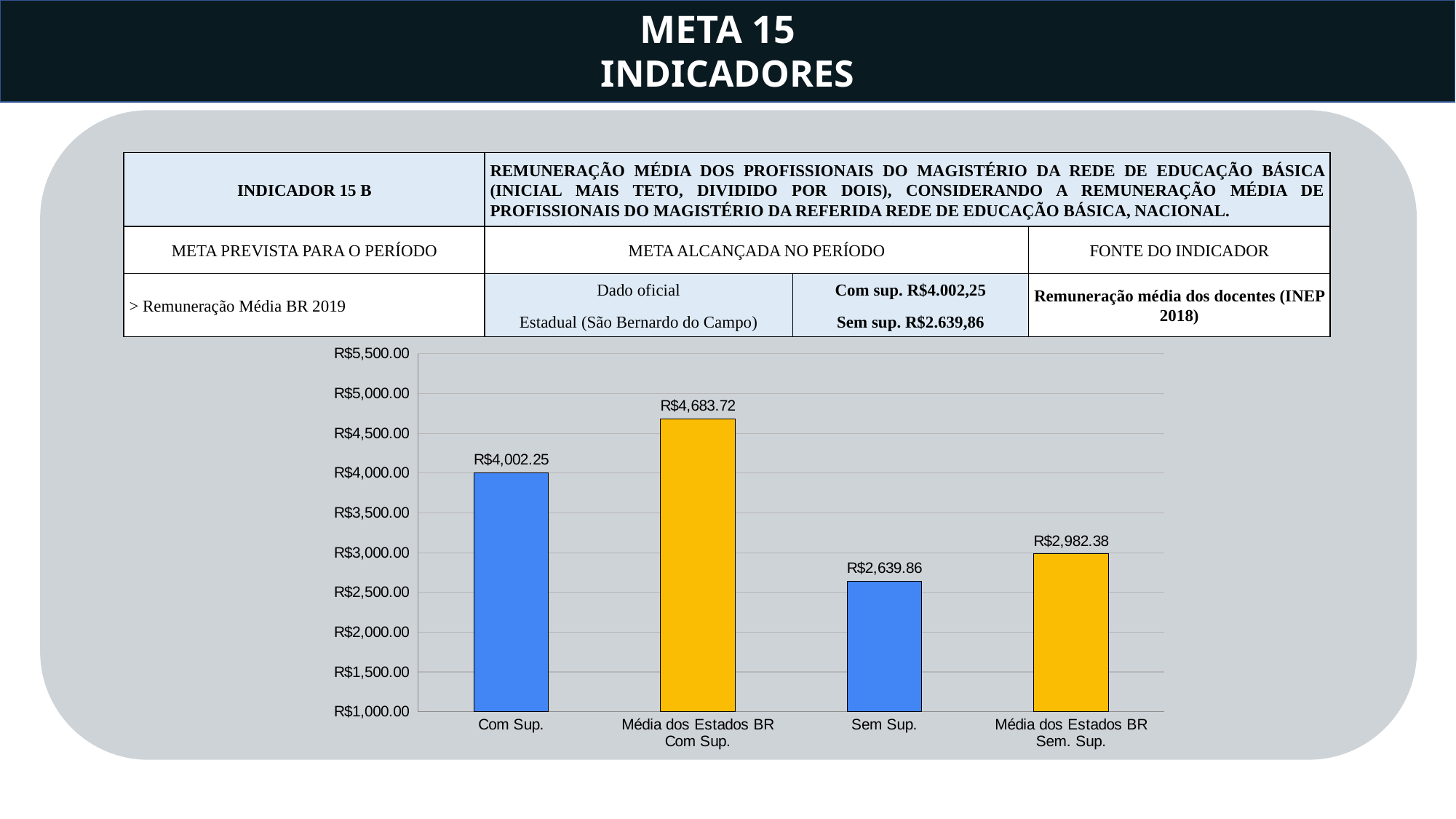
Is the value for Média dos Estados BR Sem. Sup. greater or less than R$3,000.00? less What is the difference between the values for Média dos Estados BR Sem. Sup. and Sem Sup.? R$342.52 What is the value of the bar for Sem Sup.? R$2,639.86 Which is larger, the value for Com Sup. or the value for Sem Sup.? Com Sup. Which category has the lowest value in the chart? Sem Sup. Which category has the highest value in the chart? Média dos Estados BR Com Sup. What is the value of the bar for Com Sup.? R$4,002.25 What is the value of the bar for Média dos Estados BR Com Sup.? R$4,683.72 How many bars are shown in the chart? 4 What is the difference between the values for Média dos Estados BR Com Sup. and Com Sup.? R$681.47 What is the value of the bar for Média dos Estados BR Sem. Sup.? R$2,982.38 What kind of chart is shown on the slide? bar chart